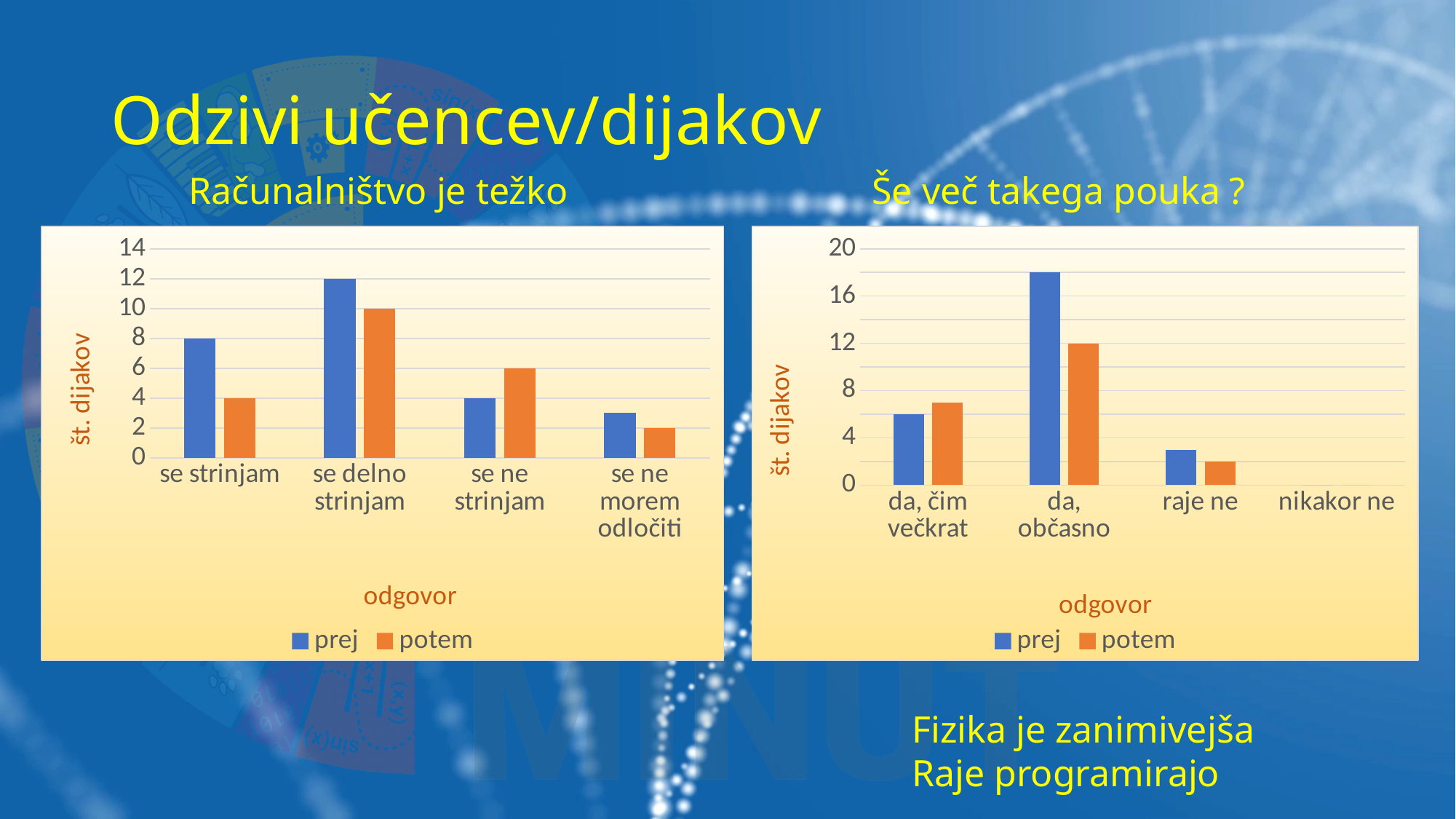
In the chart titled "Še več takega pouka ?", is the "prej" value for "da, občasno" greater or less than 16? greater In the chart titled "Računalništvo je težko", how many series does the legend list? 2 In the chart titled "Računalništvo je težko", what is the value of the "prej" series for "se strinjam"? 8 In the chart titled "Računalništvo je težko", what is the difference between the "prej" and "potem" values for "se strinjam"? 4 In the chart titled "Računalništvo je težko", what is the value of the "potem" series for "se ne strinjam"? 6 What type of chart is the chart titled "Še več takega pouka ?"? bar chart In the chart titled "Še več takega pouka ?", what is the value of the "potem" series for "da, občasno"? 12 In the chart titled "Še več takega pouka ?", which category has the highest "prej" value? da, občasno In the chart titled "Računalništvo je težko", how many categories are shown on the x axis? 4 In the chart titled "Še več takega pouka ?", for "da, občasno", which series has the larger value, "prej" or "potem"? prej In the chart titled "Računalništvo je težko", which category has the highest "prej" value? se delno strinjam In the chart titled "Računalništvo je težko", what is the value of the "prej" series for "se delno strinjam"? 12